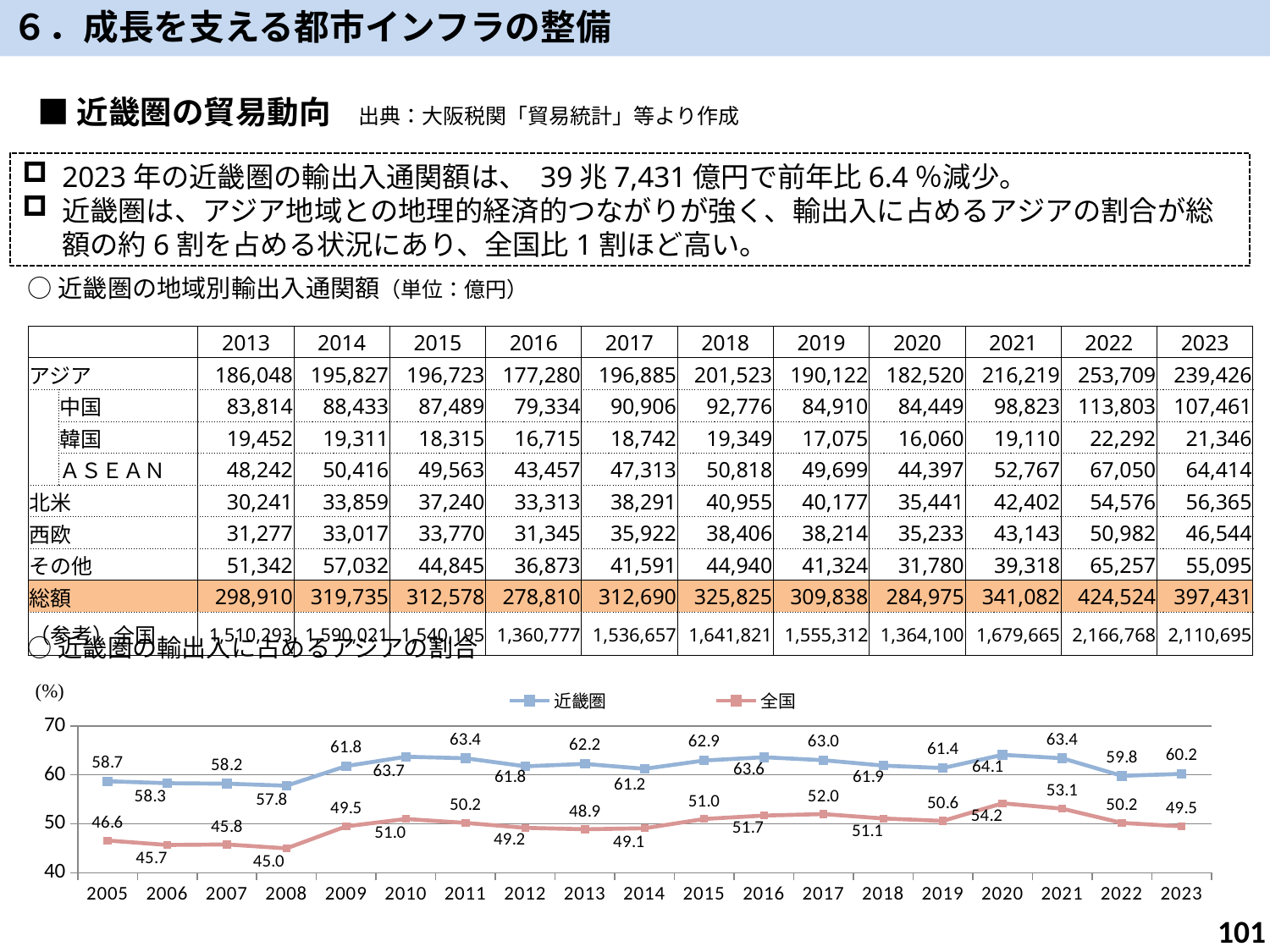
How many series does the legend of the line chart list? 2 How many years are plotted along the x axis of the line chart? 19 In the line chart, which series has the larger value in 2020, 近畿圏 or 全国? 近畿圏 In the line chart, is the value for 全国 in 2023 greater or less than 50? less In the line chart, does the 近畿圏 series rise or fall from 2005 to 2008? fall What unit is shown at the top left of the line chart's y axis? (%) In the line chart, what is the value for 全国 in 2005? 46.6 In the line chart, what is the difference between 近畿圏 and 全国 in 2023? 10.7 In the line chart, in which year is the 全国 series lowest? 2008 In the line chart, in which year is the 近畿圏 series highest? 2020 What kind of chart is shown at the bottom of the slide? line chart In the line chart, what is the value for 近畿圏 in 2023? 60.2